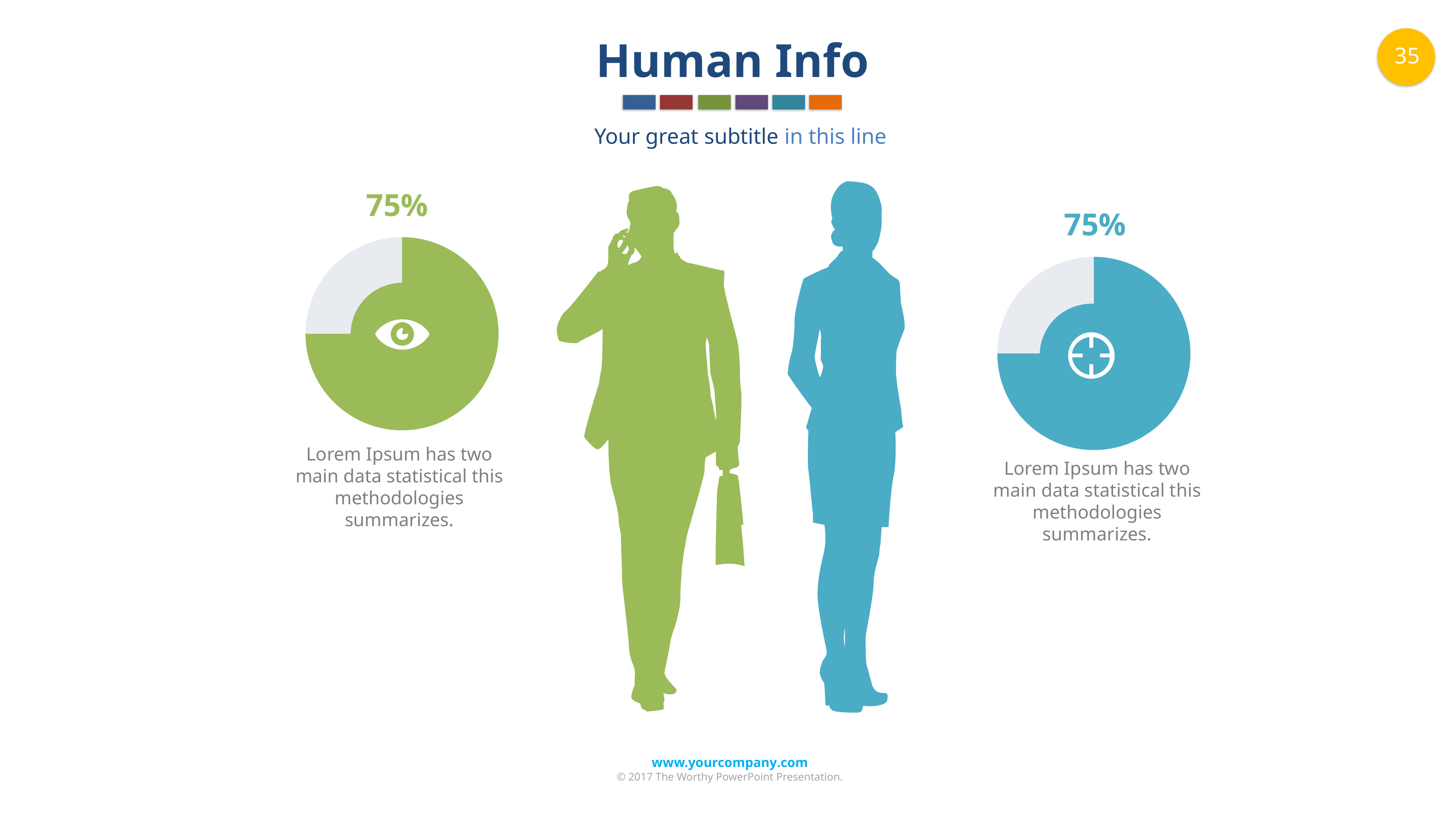
What share of the left pie chart is filled in green? 75% What is the title of the slide containing the two pie charts? Human Info What kind of chart is the green chart on the left side of the slide? pie chart Is the percentage shown for the left pie chart larger than, smaller than, or equal to the percentage shown for the right pie chart? equal How many pie charts are shown on the slide? 2 How many slices does the right pie chart have? 2 How many slices does the left pie chart have? 2 What percentage is printed above the blue pie chart on the right? 75% What colour is the filled portion of the pie chart on the left? green What kind of chart is the blue chart on the right side of the slide? pie chart What percentage is printed above the green pie chart on the left? 75% What share of the right pie chart is filled in blue? 75%